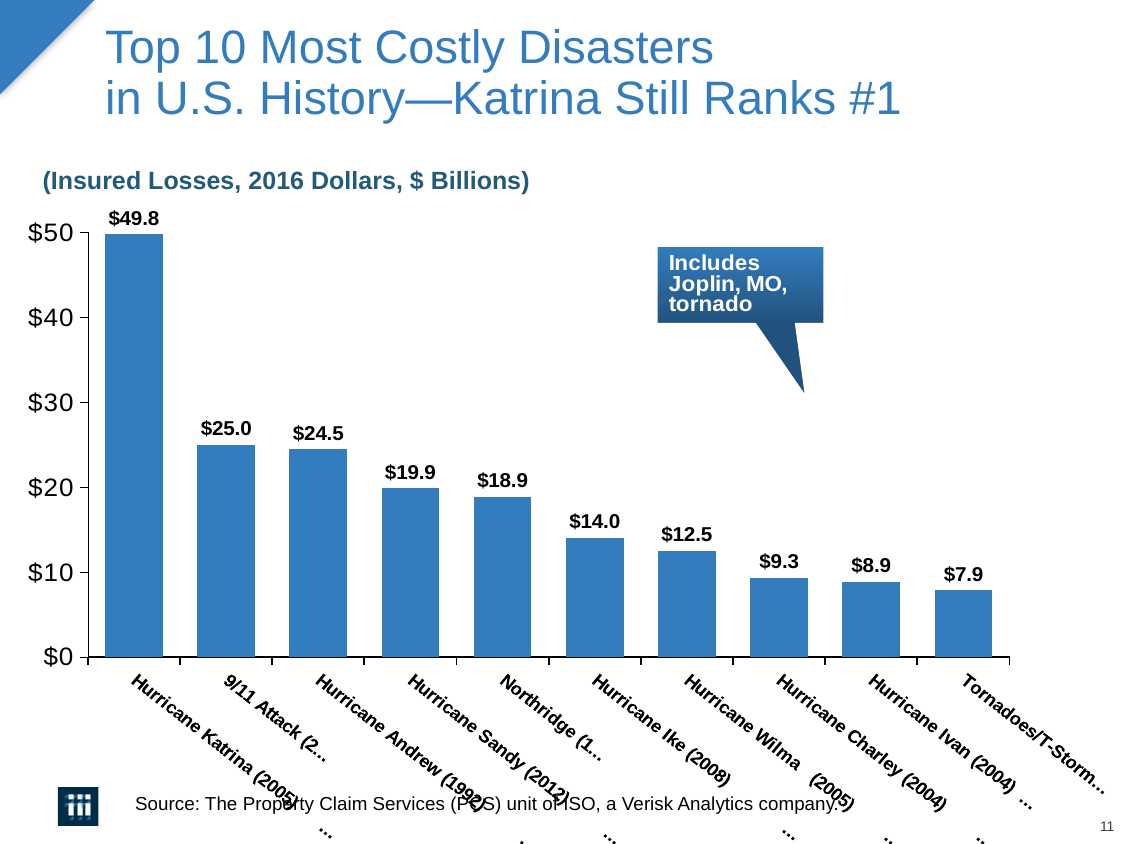
What is the insured loss value shown for Hurricane Charley (2004)? $9.3 Which disaster has the lowest insured loss on the chart? Tornadoes/T-Storm What is the difference between the insured losses for Hurricane Katrina (2005) and Hurricane Andrew (1992)? $25.3 Which disaster has the highest insured loss on the chart? Hurricane Katrina (2005) What type of chart is shown on the slide? Bar chart What is the insured loss value shown for Hurricane Sandy (2012)? $19.9 Which has a larger insured loss, Hurricane Sandy (2012) or Hurricane Ivan (2004)? Hurricane Sandy (2012) Do the values rise or fall moving from left to right along the x axis? Fall How many disasters are plotted on the chart? 10 What is the insured loss value shown for Hurricane Katrina (2005)? $49.8 What is the insured loss value shown for Hurricane Ike (2008)? $14.0 What is the difference between the insured losses for Hurricane Ike (2008) and Hurricane Wilma (2005)? $1.5